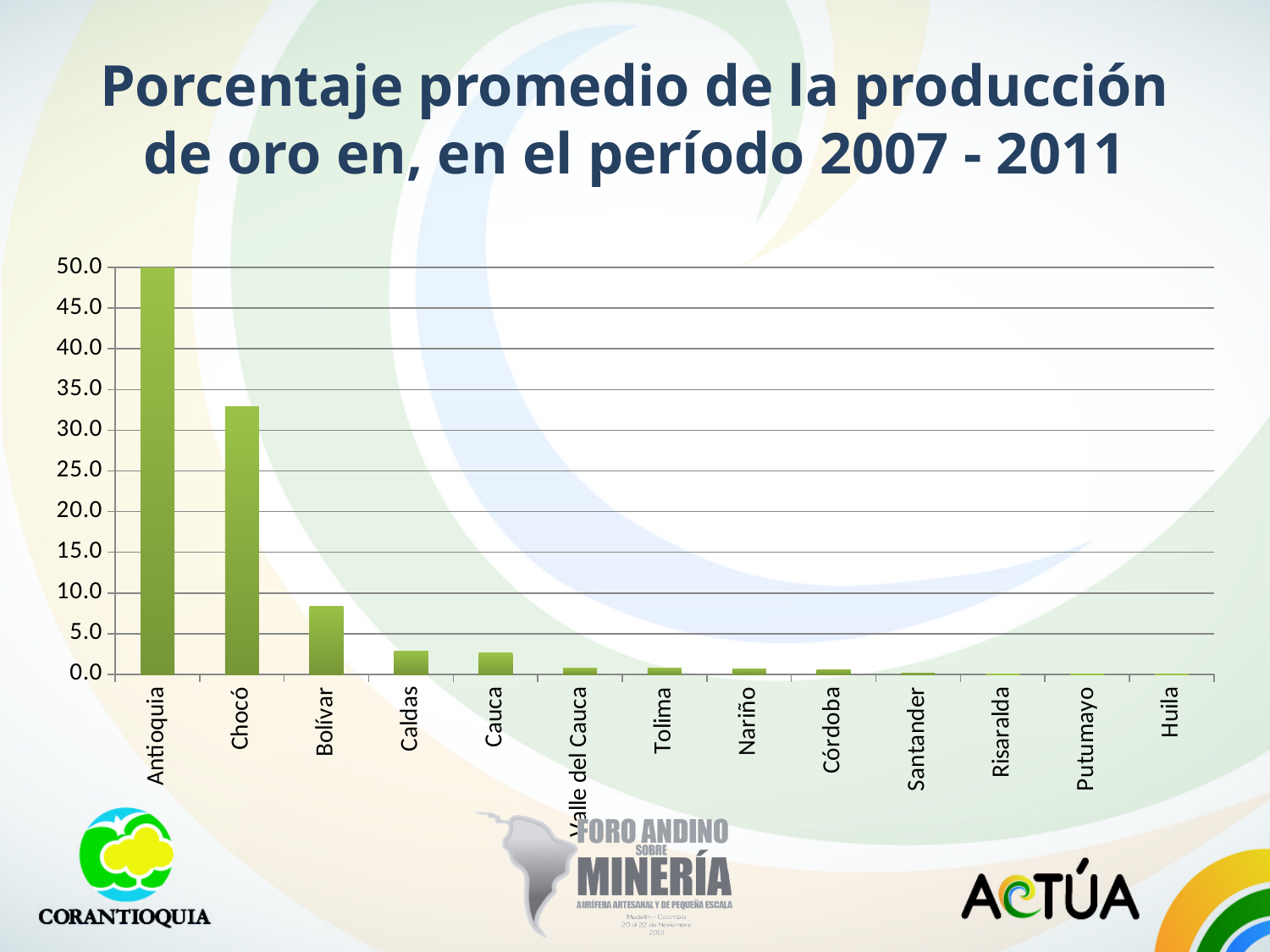
What kind of chart is shown on the slide? bar chart Do the values rise or fall moving from left to right along the x axis? fall Is the value for Antioquia greater or less than 45.0? greater Which department has the highest average percentage of gold production? Antioquia Is the value for Chocó greater or less than 30.0? greater How many departments are shown on the x axis of the chart? 13 Is the value for Bolívar greater or less than 10.0? less Which has a larger value, Chocó or Bolívar? Chocó What is the title of the chart on the slide? Porcentaje promedio de la producción de oro en, en el período 2007 - 2011